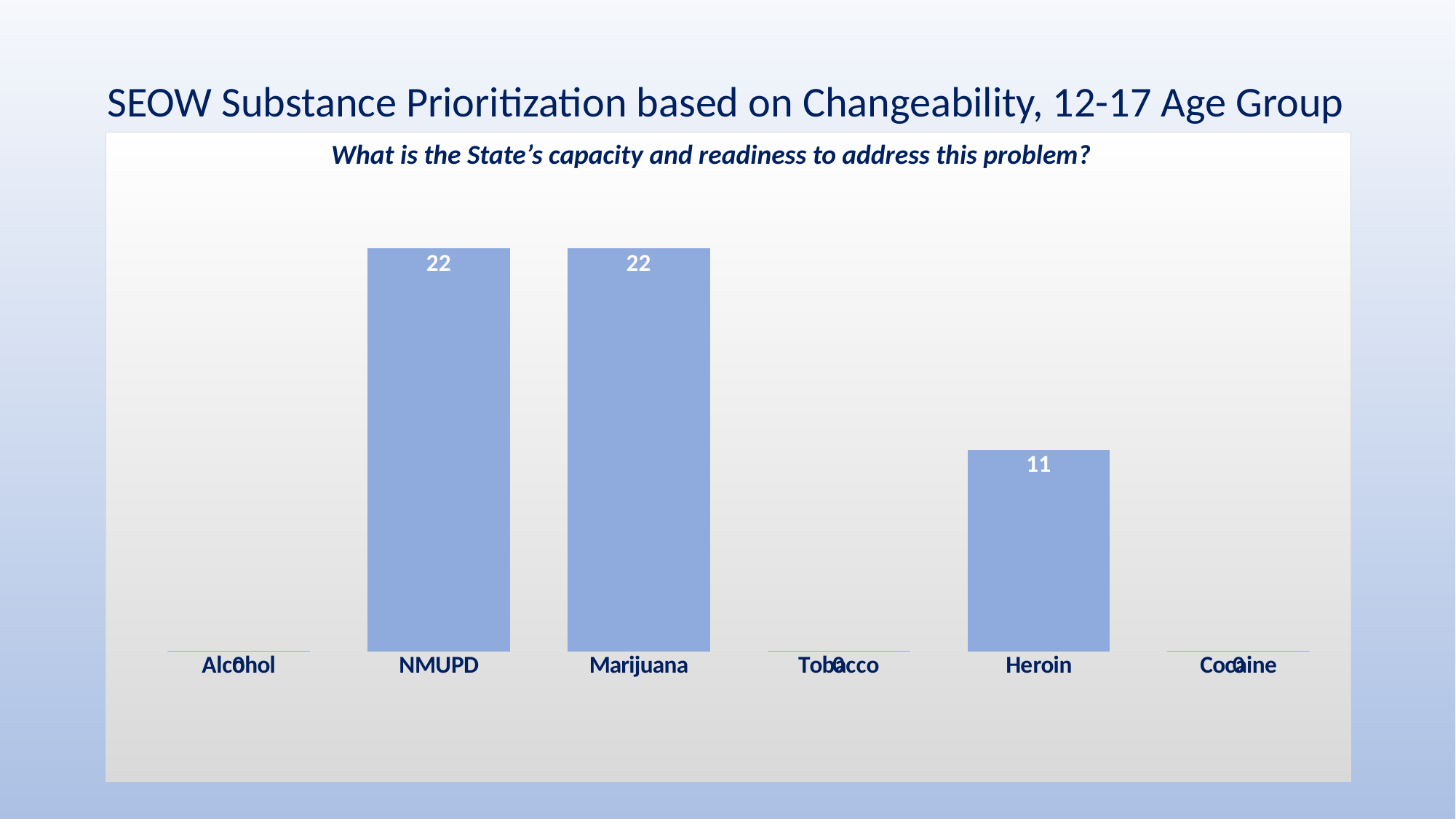
What is the value for Alcohol? 0 Which is larger, the value for Heroin or the value for Tobacco? Heroin How many categories are shown on the x axis? 6 What is the value for NMUPD? 22 What is the title of the chart? What is the State's capacity and readiness to address this problem? What is the value for Marijuana? 22 What is the value for Cocaine? 0 Which is larger, the value for Marijuana or the value for Heroin? Marijuana What is the value for Tobacco? 0 What is the difference between the values for NMUPD and Heroin? 11 What is the value for Heroin? 11 What kind of chart is shown on the slide? Bar chart